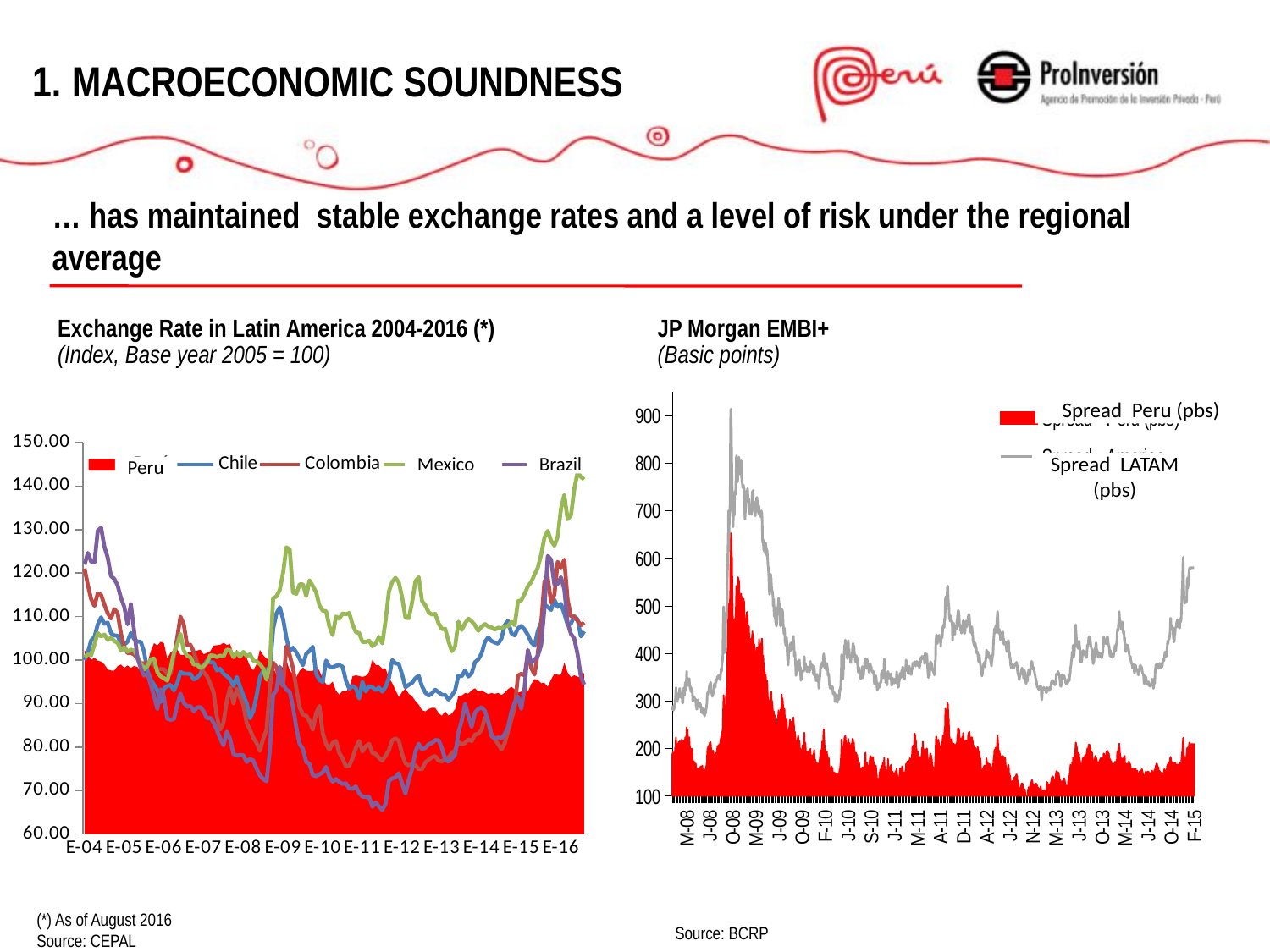
In the Exchange Rate in Latin America chart, is the value for Mexico at E-16 greater or less than 130? greater In the JP Morgan EMBI+ chart, does Spread LATAM rise or fall between O-08 and O-09? fall In the Exchange Rate in Latin America chart, how many series does the legend list? 5 In the JP Morgan EMBI+ chart, which series is higher throughout the period, Spread Peru or Spread LATAM? Spread LATAM In the Exchange Rate in Latin America chart, which country has the highest index value at E-16? Mexico In the JP Morgan EMBI+ chart, is the value of Spread Peru at F-15 greater or less than 300? less In the Exchange Rate in Latin America chart, which series is shown as a red filled area? Peru In the JP Morgan EMBI+ chart, is the peak value of Spread LATAM greater or less than 800? greater What kind of chart is the JP Morgan EMBI+ chart? area and line chart In the JP Morgan EMBI+ chart, how many series does the legend list? 2